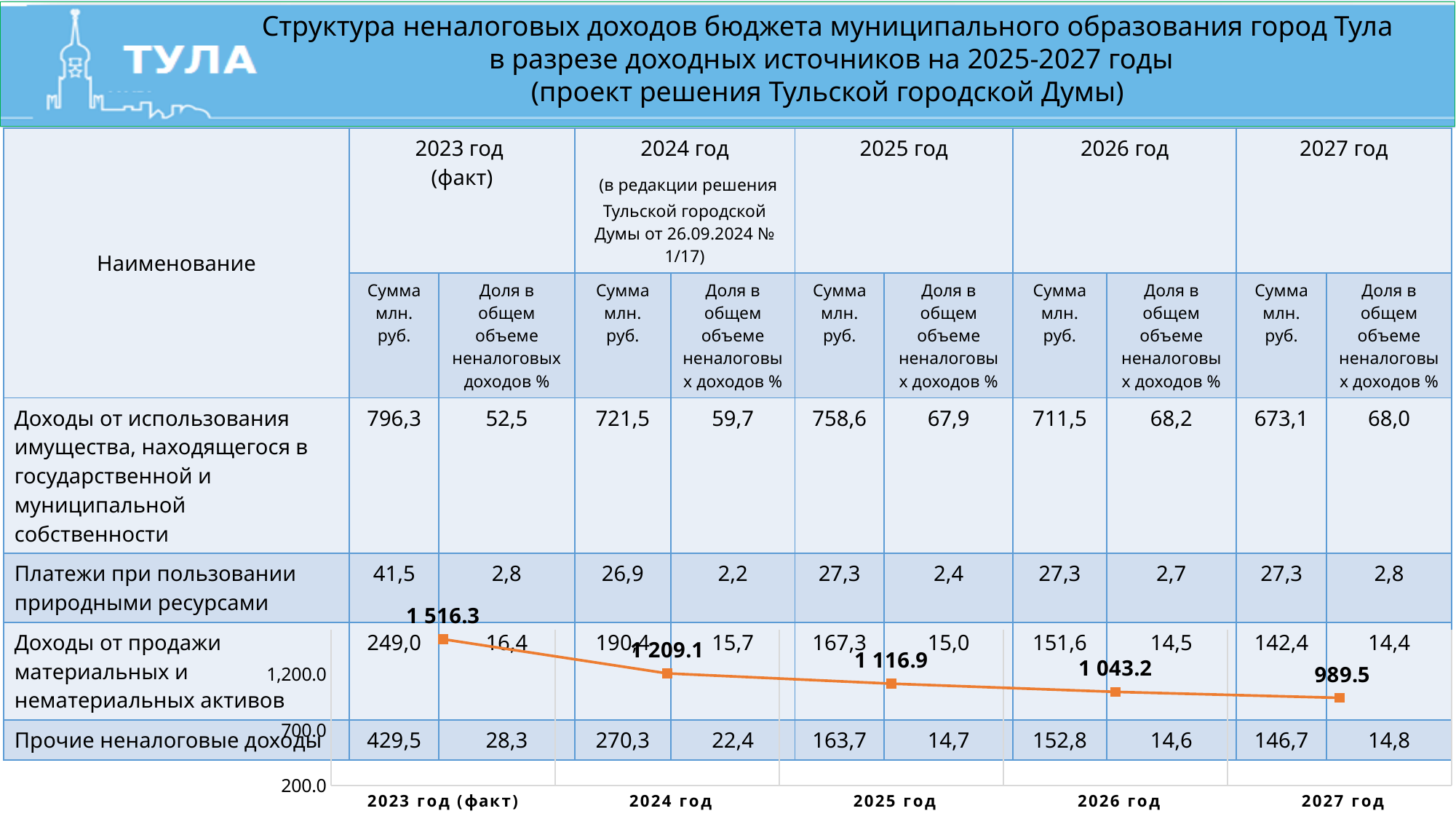
Which year has the highest value on the line chart? 2023 год (факт) What is the difference between the 2023 год (факт) value and the 2027 год value on the line chart? 526.8 What is the value plotted for 2027 год on the line chart? 989.5 Do the values on the line chart rise or fall from 2023 to 2027? fall What is the value plotted for 2023 год (факт) on the line chart? 1 516.3 What is the value plotted for 2024 год on the line chart? 1 209.1 What is the value plotted for 2025 год on the line chart? 1 116.9 Is the value for 2027 год on the line chart greater or less than 1,200.0? less How many data points are plotted on the line chart? 5 What type of chart is shown at the bottom of the slide? line chart What is the value plotted for 2026 год on the line chart? 1 043.2 Which year has the lowest value on the line chart? 2027 год